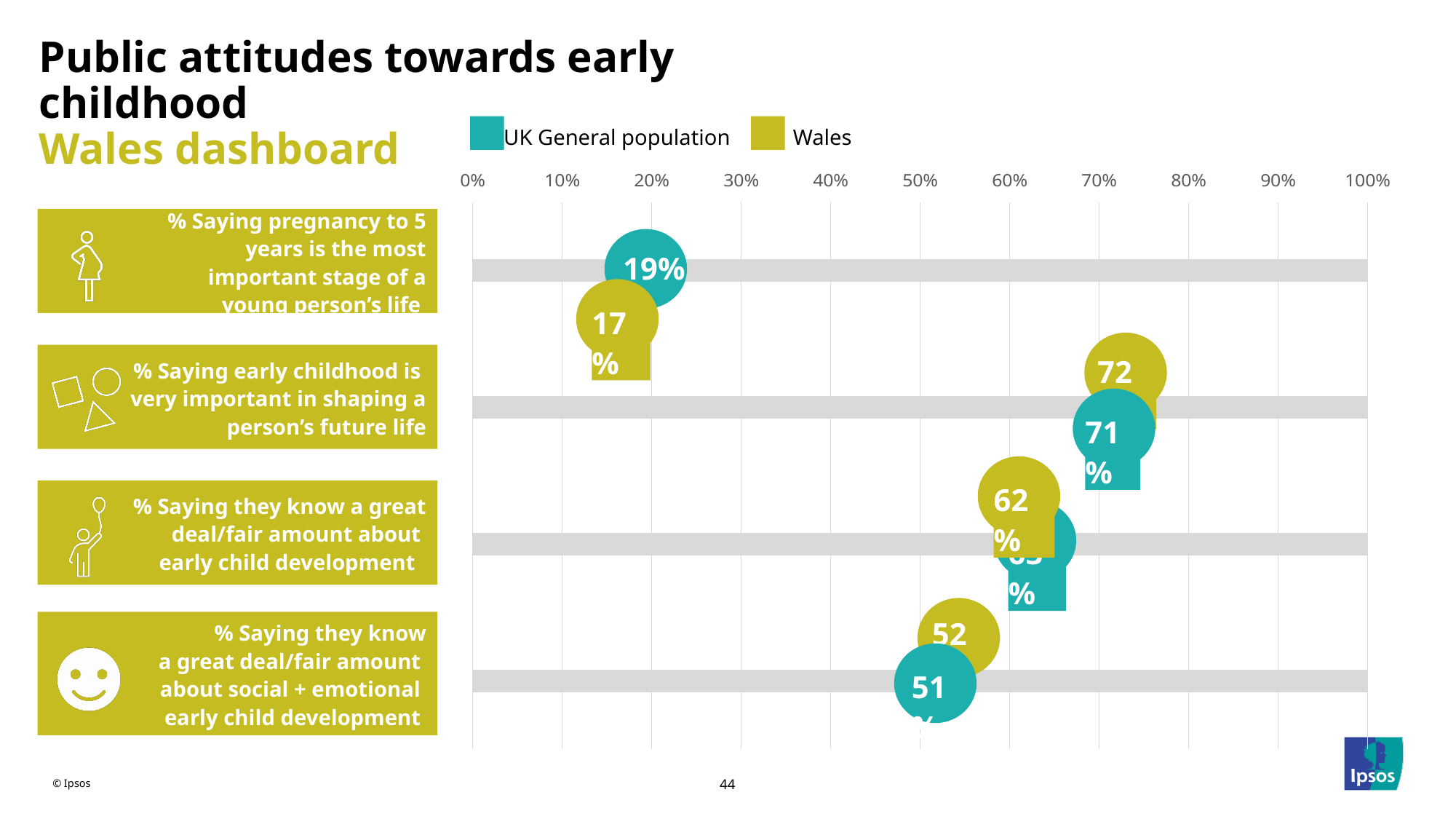
How many series does the legend list? 2 How many statements (categories) are plotted on the chart? 4 What percentage of Wales respondents say pregnancy to 5 years is the most important stage of a young person's life? 17% What percentage of the UK General population say early childhood is very important in shaping a person's future life? 71% What percentage of the UK General population say pregnancy to 5 years is the most important stage of a young person's life? 19% What percentage of the UK General population say they know a great deal/fair amount about social + emotional early child development? 51% What percentage of Wales respondents say early childhood is very important in shaping a person's future life? 72% Which series is shown in teal in the legend? UK General population What percentage of Wales respondents say they know a great deal/fair amount about early child development? 62% What is the difference between the UK General population and Wales values for saying pregnancy to 5 years is the most important stage of a young person's life? 2 percentage points What percentage of Wales respondents say they know a great deal/fair amount about social + emotional early child development? 52% Is the UK General population value for knowing a great deal/fair amount about early child development greater or less than 50%? greater